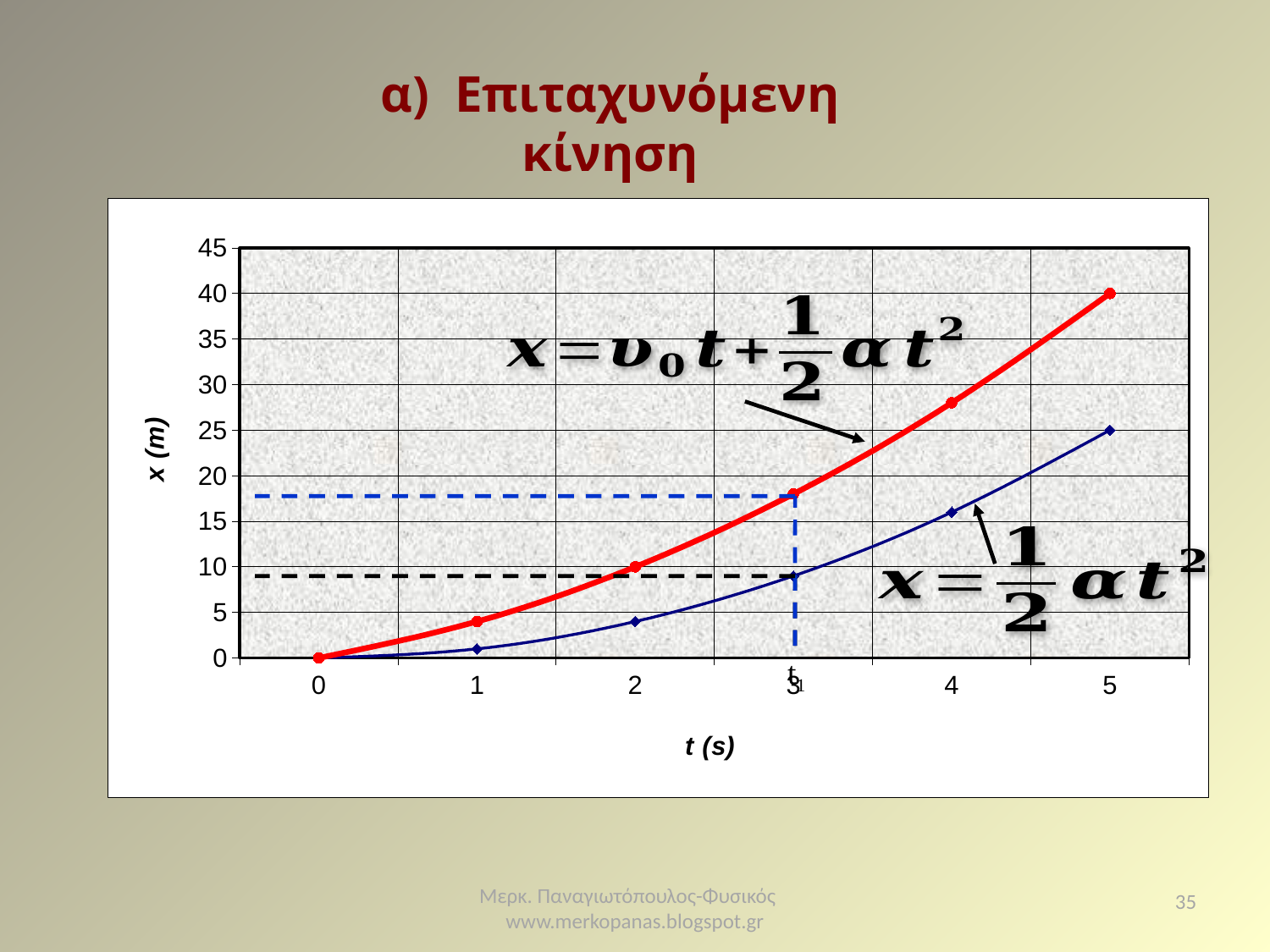
What is the value of the red curve at t = 2 s? 10 How many data points are plotted on the red curve? 6 What is the value of the blue curve at t = 5 s? 25 At t = 5 s, which curve has the larger value, the red one or the blue one? red What is the difference between the red curve and the blue curve at t = 5 s? 15 Is the value of the blue curve at t = 3 s greater or less than 10? less What is the label of the vertical axis? x (m) Is the value of the blue curve at t = 4 s greater or less than 15? greater Do the values of the red curve rise or fall as t increases? rise What is the value of the red curve at t = 5 s? 40 Is the value of the red curve at t = 4 s greater or less than 25? greater What type of chart is shown on the slide? line chart